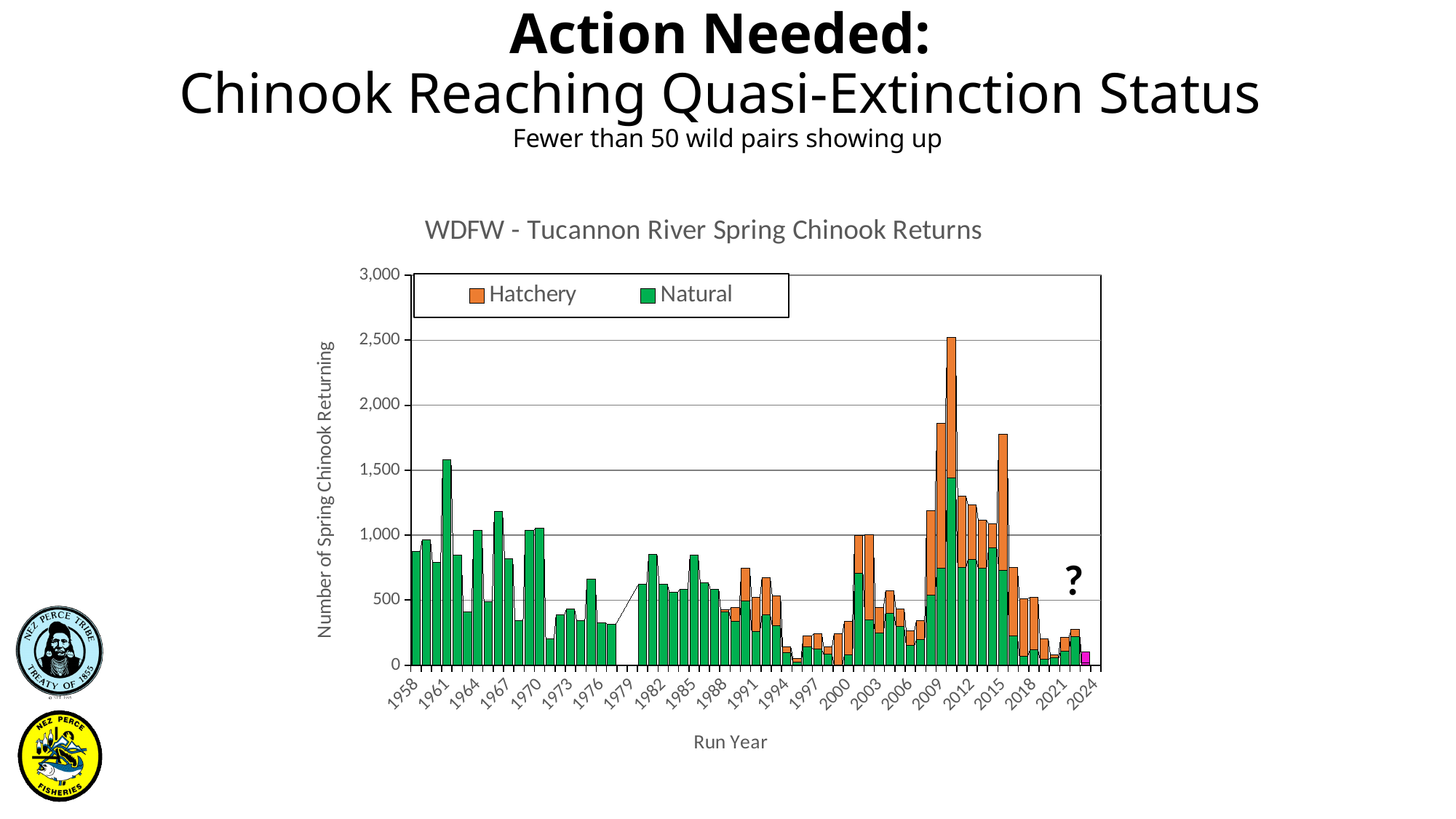
Is the total value for run year 1961 greater or less than 1,000? greater What is the title of the chart? WDFW - Tucannon River Spring Chinook Returns What kind of chart is shown on the slide? Stacked bar chart How many series does the chart legend list? 2 Is the total value for run year 2010 greater or less than 2,000? greater Is the total value for run year 2019 greater or less than 500? less Do the total returns rise or fall from run year 2015 to run year 2019? fall Which run year has a larger total return, 2010 or 2015? 2010 In run year 2001, which series is larger, Hatchery or Natural? Natural What are the two series named in the chart legend? Hatchery and Natural Which run year has the highest total number of Spring Chinook returning? 2010